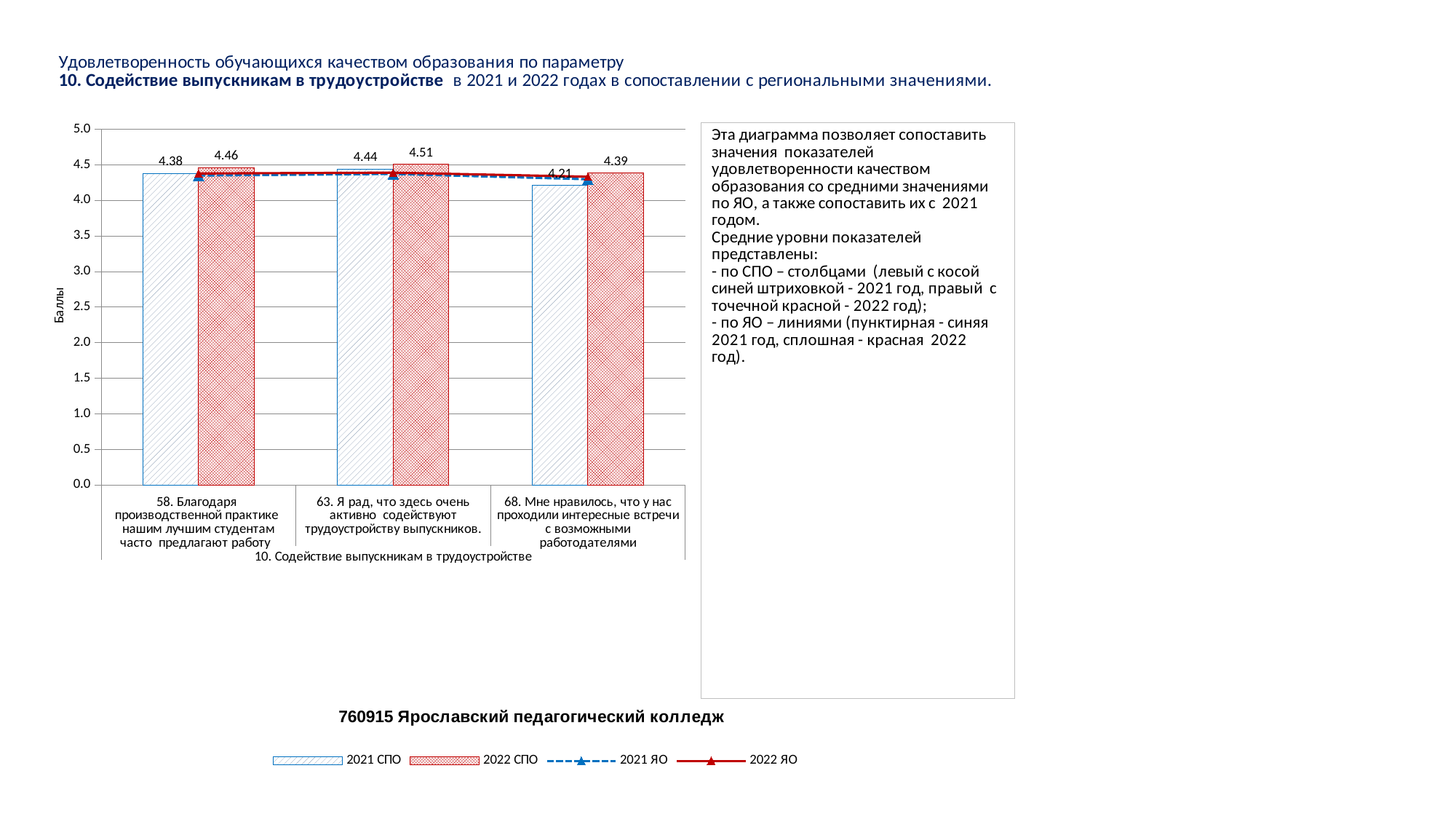
What is the 2021 СПО value for category "58. Благодаря производственной практике нашим лучшим студентам часто предлагают работу"? 4.38 What is the difference between the 2022 СПО and 2021 СПО values for category "68. Мне нравилось, что у нас проходили интересные встречи с возможными работодателями"? 0.18 How many categories are shown on the x axis of the chart? 3 Which category has the lowest 2021 СПО value? 68. Мне нравилось, что у нас проходили интересные встречи с возможными работодателями Which category has the highest 2022 СПО value? 63. Я рад, что здесь очень активно содействуют трудоустройству выпускников. What is the 2022 СПО value for category "63. Я рад, что здесь очень активно содействуют трудоустройству выпускников."? 4.51 What is the 2022 СПО value for category "58. Благодаря производственной практике нашим лучшим студентам часто предлагают работу"? 4.46 Is the 2021 СПО value for category "68. Мне нравилось, что у нас проходили интересные встречи с возможными работодателями" greater or less than 4.5? less What is the label of the vertical axis of the chart? Баллы How many series does the chart legend list? 4 What is the 2021 СПО value for category "68. Мне нравилось, что у нас проходили интересные встречи с возможными работодателями"? 4.21 For category "63. Я рад, что здесь очень активно содействуют трудоустройству выпускников.", which is larger: the 2021 СПО value or the 2022 СПО value? 2022 СПО